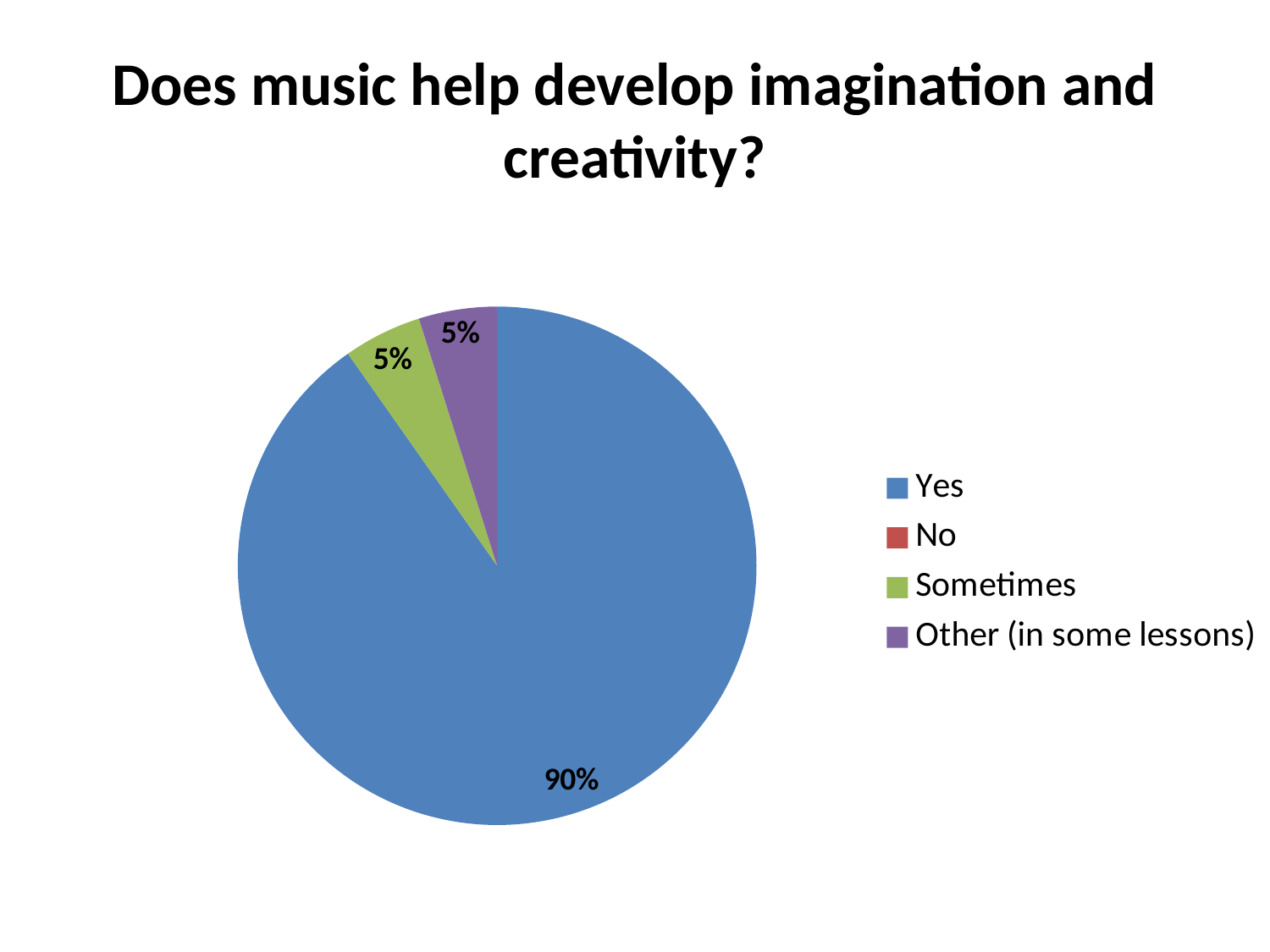
Which category has the largest slice of the pie? Yes What kind of chart is shown on the slide? pie chart What share of the pie does the "Other (in some lessons)" slice represent? 5% What colour is the "Yes" slice of the pie? blue What is the combined share of the "Sometimes" and "Other (in some lessons)" slices? 10% What share of the pie does the "Yes" slice represent? 90% Is the share for "Yes" greater or less than 50%? greater Which is larger, the share for "Yes" or the share for "Other (in some lessons)"? Yes What is the title of the chart? Does music help develop imagination and creativity? What is the difference between the share for "Yes" and the share for "Sometimes"? 85% How many entries does the legend list? 4 What share of the pie does the "Sometimes" slice represent? 5%